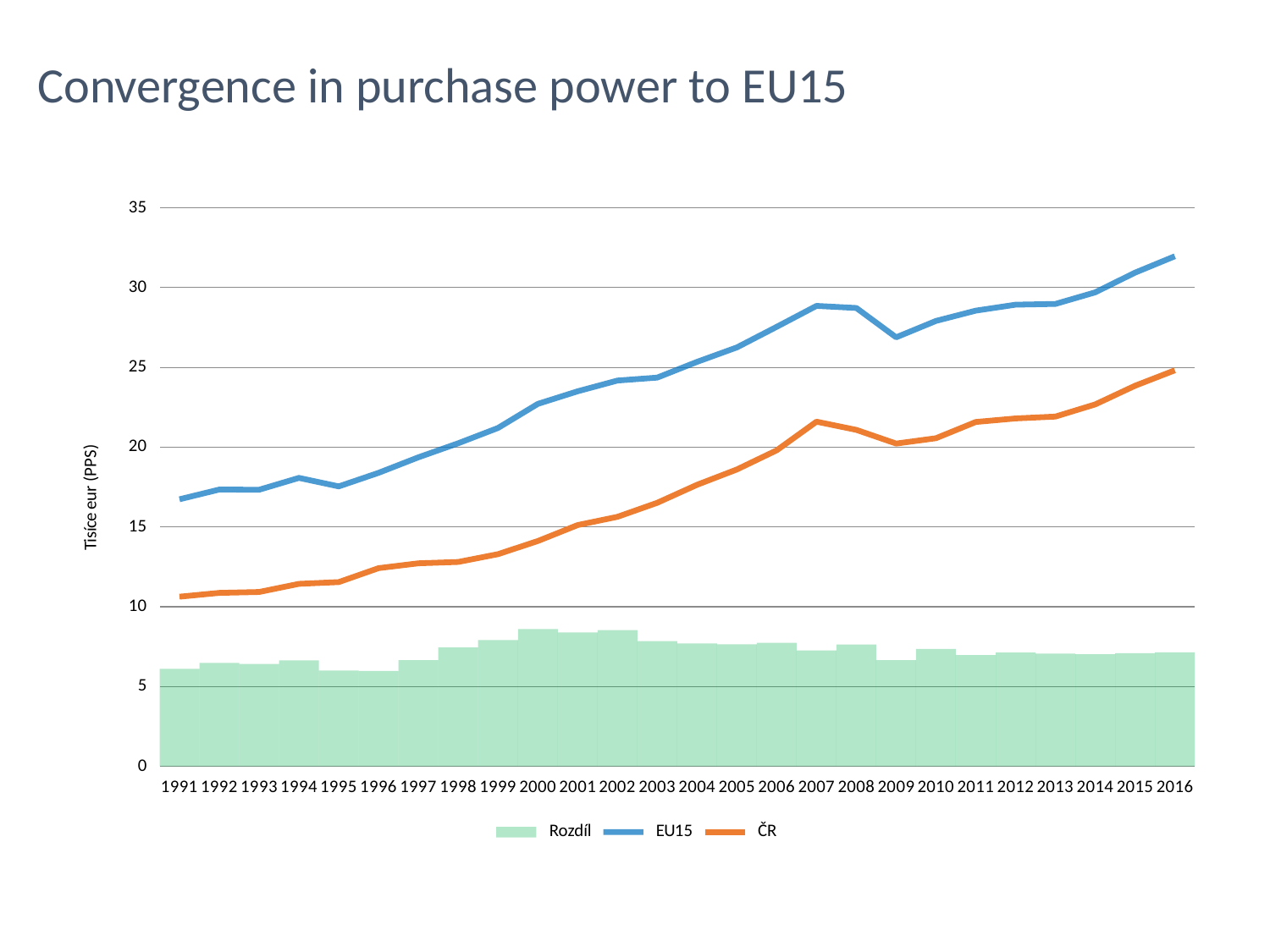
Does the EU15 series generally rise or fall from 1991 to 2016? rise What kind of chart is used to plot the EU15 and ČR series? line chart In which year is the ČR value highest? 2016 Is the ČR value for 1991 greater or less than 15? less What is the label of the y axis? Tisíce eur (PPS) Is the EU15 value for 2016 greater or less than 30? greater How many years are shown on the x axis? 26 Is the ČR value for 2007 greater or less than 20? greater In 2016, which series has the larger value, EU15 or ČR? EU15 How many series does the legend list? 3